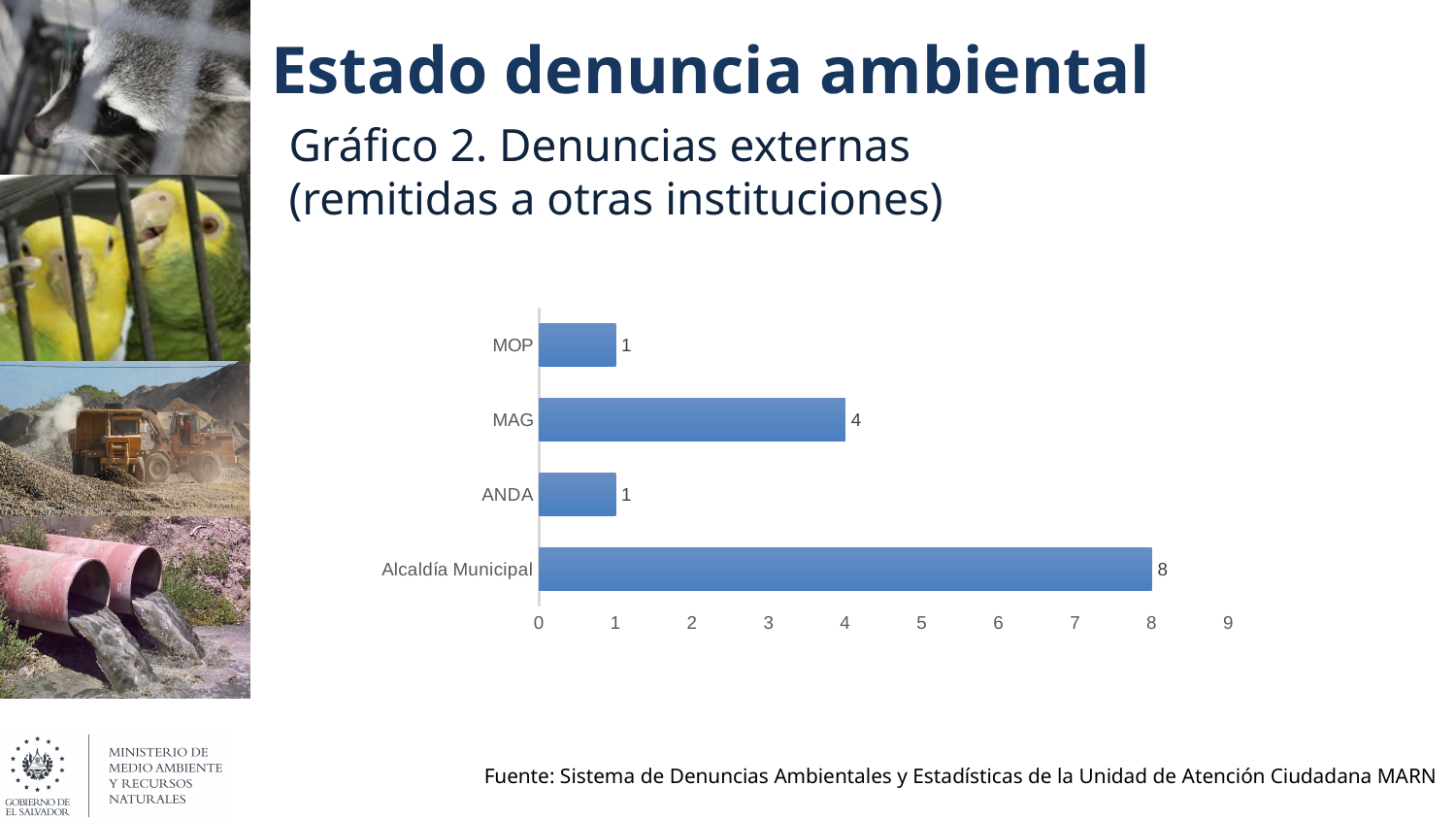
What is the value for MOP? 1 What is the value for Alcaldía Municipal? 8 What is the value for ANDA? 1 What is the value for MAG? 4 What is the title of the chart on the slide? Gráfico 2. Denuncias externas (remitidas a otras instituciones) Which category has the highest value? Alcaldía Municipal What is the difference between the values for Alcaldía Municipal and MAG? 4 Which is larger, the value for MAG or the value for MOP? MAG Is the value for Alcaldía Municipal greater or less than 5? greater What is the difference between the values for MAG and ANDA? 3 How many categories are shown in the chart? 4 What kind of chart is shown on the slide? Bar chart